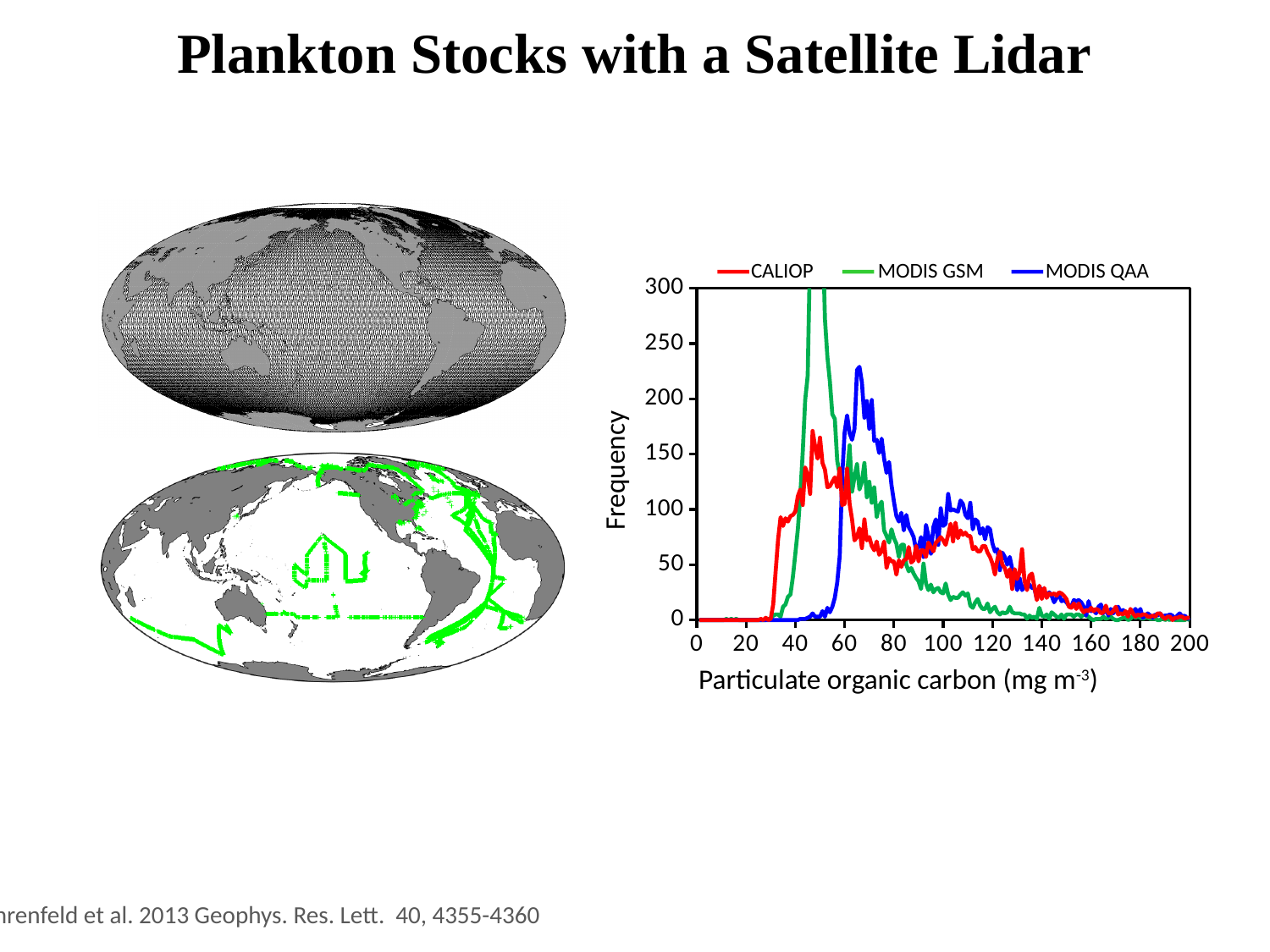
How many series does the legend of the frequency chart list? 3 Do the frequency values of all three series rise or fall as particulate organic carbon increases from 120 to 200 mg m-3? fall Is the peak frequency of the MODIS GSM series greater or less than 250? greater Which series has the higher peak frequency, MODIS QAA or CALIOP? MODIS QAA Is the peak frequency of the CALIOP series greater or less than 200? less What kind of chart is shown on the right of the slide? line chart What is the maximum value shown on the y axis of the frequency chart? 300 Which series in the frequency chart has the lowest peak frequency? CALIOP What is the label of the x axis of the frequency chart? Particulate organic carbon (mg m-3) Which series in the frequency chart reaches the highest peak frequency? MODIS GSM Is the peak frequency of the MODIS QAA series greater or less than 200? greater Which colour is used for the CALIOP series in the frequency chart? red